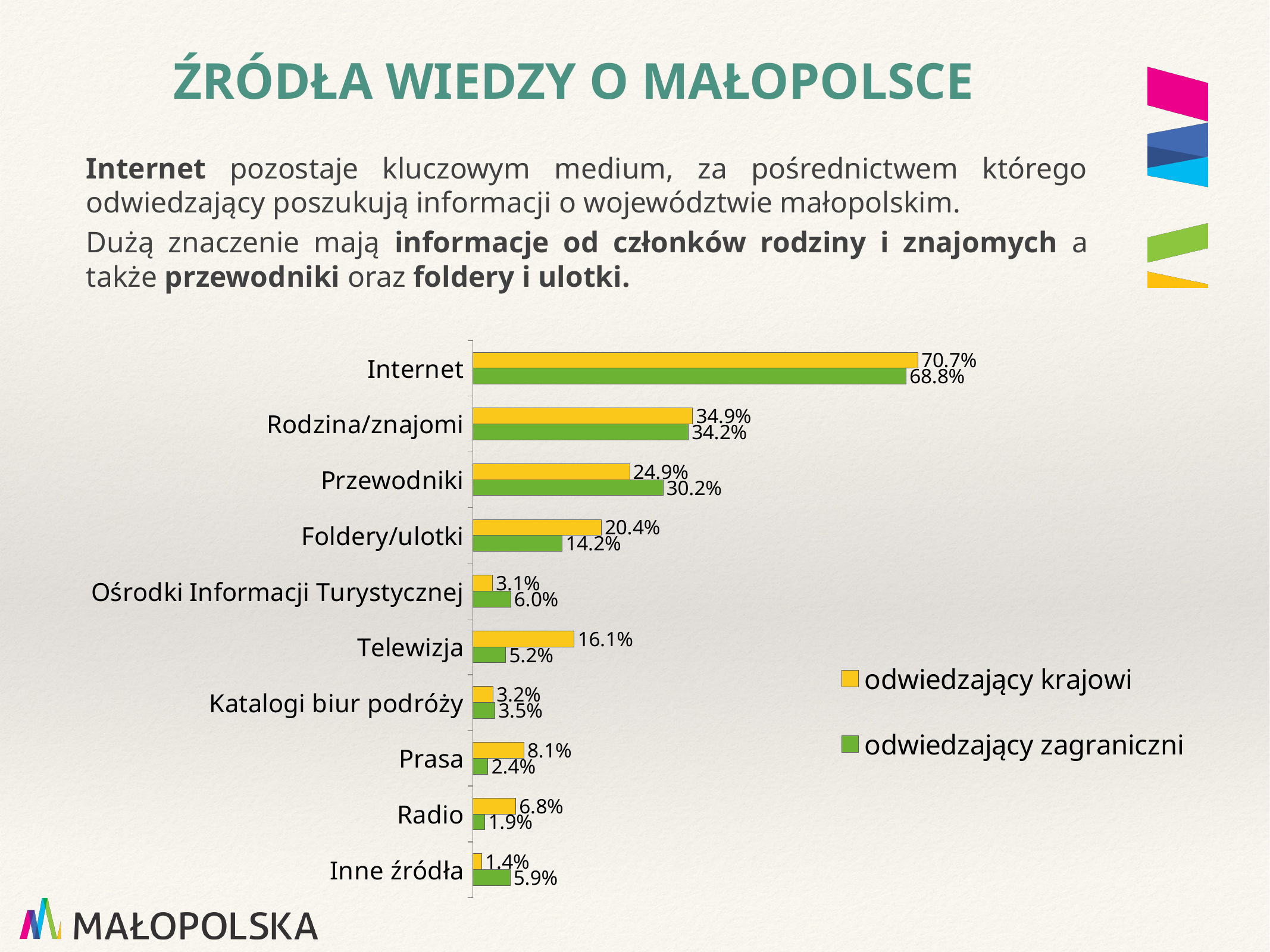
Which category has the highest value in the 'odwiedzający zagraniczni' series? Internet How many categories are shown in the chart? 10 What is the value for Telewizja in the 'odwiedzający krajowi' series? 16.1% For Przewodniki, which series has the larger value: 'odwiedzający krajowi' or 'odwiedzający zagraniczni'? odwiedzający zagraniczni What is the value for Radio in the 'odwiedzający zagraniczni' series? 1.9% How many series does the legend list? 2 What kind of chart is shown on the slide? bar chart What is the value for Internet in the 'odwiedzający krajowi' series? 70.7% What is the value for Przewodniki in the 'odwiedzający zagraniczni' series? 30.2% What is the difference between the 'odwiedzający krajowi' and 'odwiedzający zagraniczni' values for Foldery/ulotki? 6.2% What colour are the bars for the 'odwiedzający krajowi' series? yellow Which category has the lowest value in the 'odwiedzający krajowi' series? Inne źródła